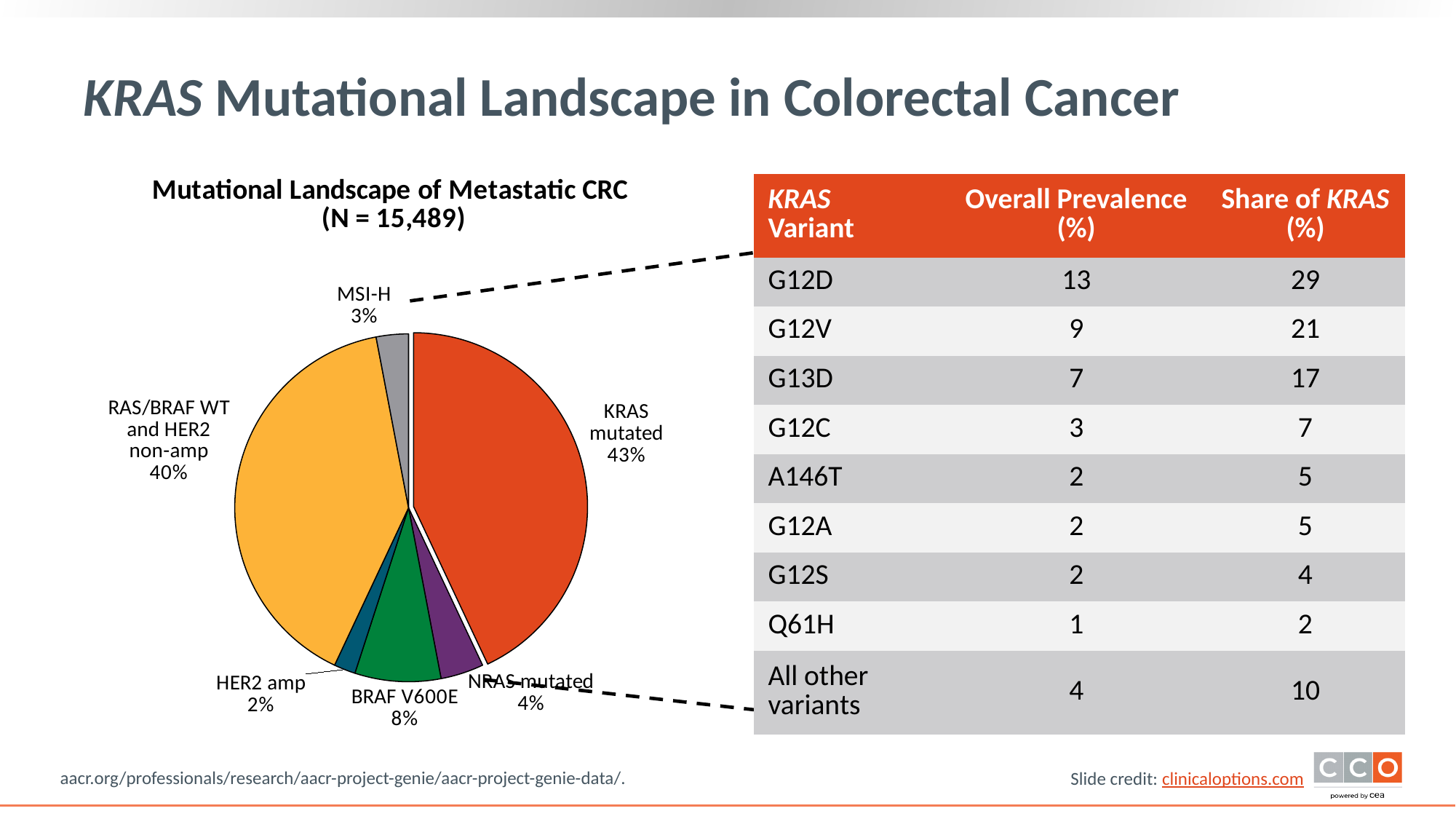
What is the difference in percentage points between KRAS mutated and RAS/BRAF WT and HER2 non-amp? 3 Which slice of the pie chart is the largest? KRAS mutated What percentage is shown for MSI-H? 3% Which slice of the pie chart is the smallest? HER2 amp What share of the pie is RAS/BRAF WT and HER2 non-amp? 40% What is the title of the pie chart? Mutational Landscape of Metastatic CRC (N = 15,489) What is the sample size (N) stated in the pie chart title? 15,489 How many slices does the pie chart have? 6 Which is larger, the NRAS mutated slice or the BRAF V600E slice? BRAF V600E What type of chart is shown on the slide? Pie chart What share of the pie is KRAS mutated? 43% What percentage is shown for BRAF V600E? 8%